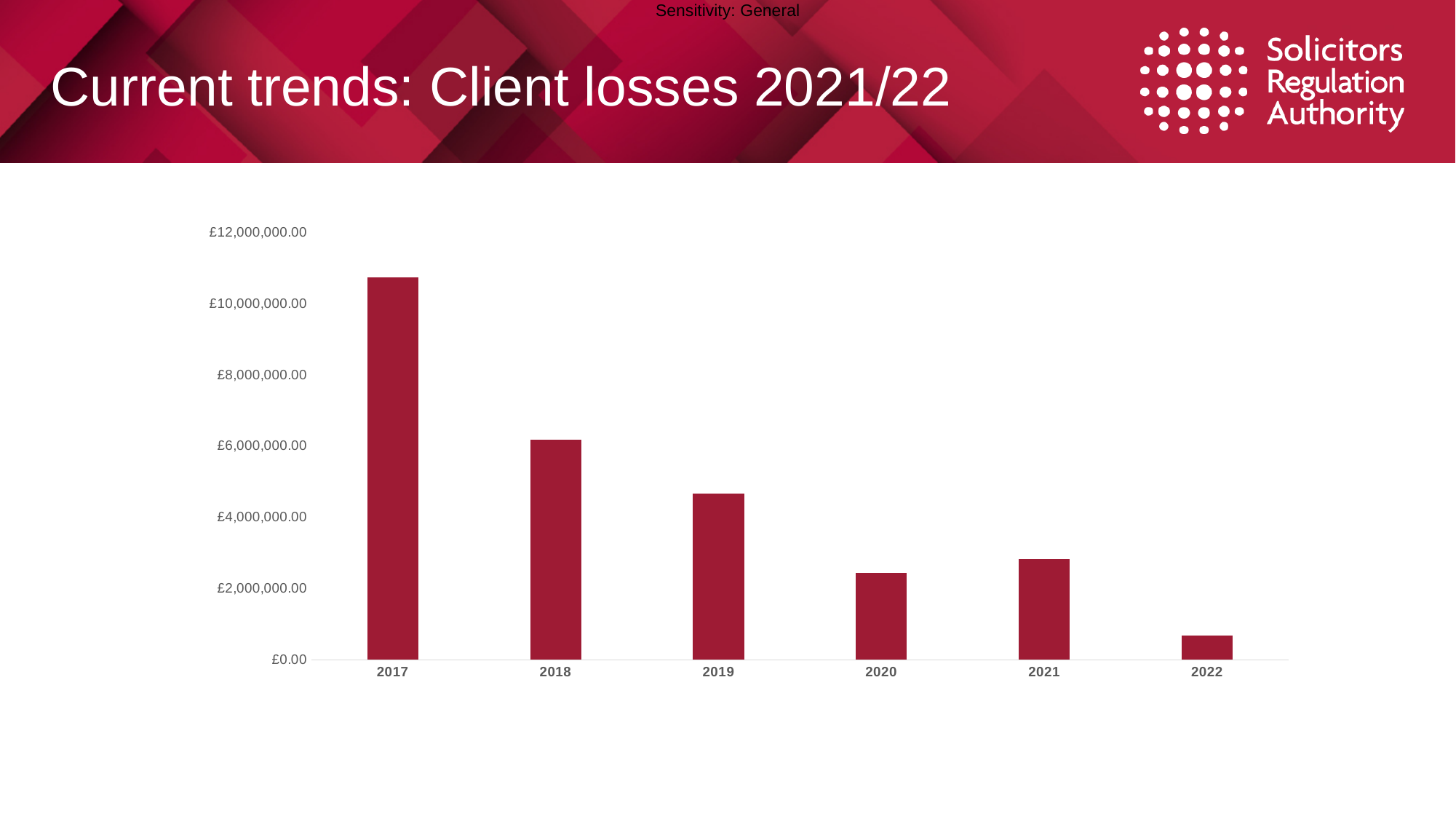
Is the value for 2017 greater or less than £10,000,000.00? greater Is the value for 2019 greater or less than £4,000,000.00? greater Is the value for 2022 greater or less than £2,000,000.00? less What is the title of the slide containing the chart? Current trends: Client losses 2021/22 What kind of chart is shown on the slide? bar chart Which is larger, the value for 2020 or the value for 2021? 2021 Which year has the lowest client losses? 2022 How many years are plotted on the chart? 6 Which year has the highest client losses? 2017 Do the values generally rise or fall from 2017 to 2022? fall